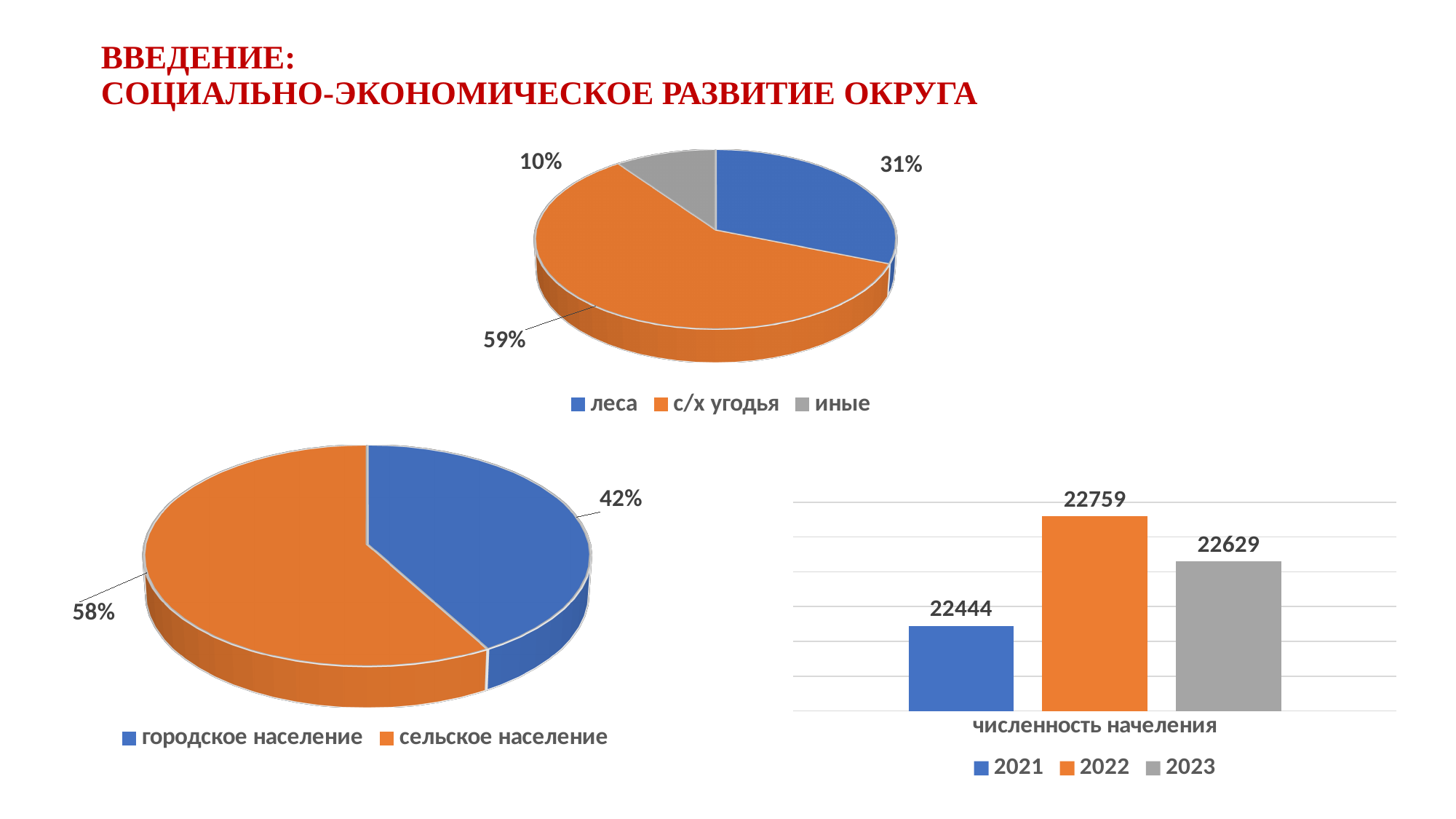
What kind of chart is the bottom-right chart? bar chart In the bottom-right bar chart, what is the difference between the values for 2022 and 2023? 130 In the top pie chart, what share is labelled for леса? 31% In the bottom-left pie chart, what share is labelled for сельское население? 58% In the top pie chart, which category has the largest slice? с/х угодья In the bottom-left pie chart, what is the difference between the shares of сельское население and городское население? 16% In the bottom-left pie chart, which is larger: городское население or сельское население? сельское население In the top pie chart, which category has the smallest slice? иные In the bottom-right bar chart, which year has the lowest value? 2021 How many categories does the legend of the top pie chart list? 3 In the top pie chart, what share is labelled for с/х угодья? 59% In the bottom-right bar chart, what is the value for 2022? 22759